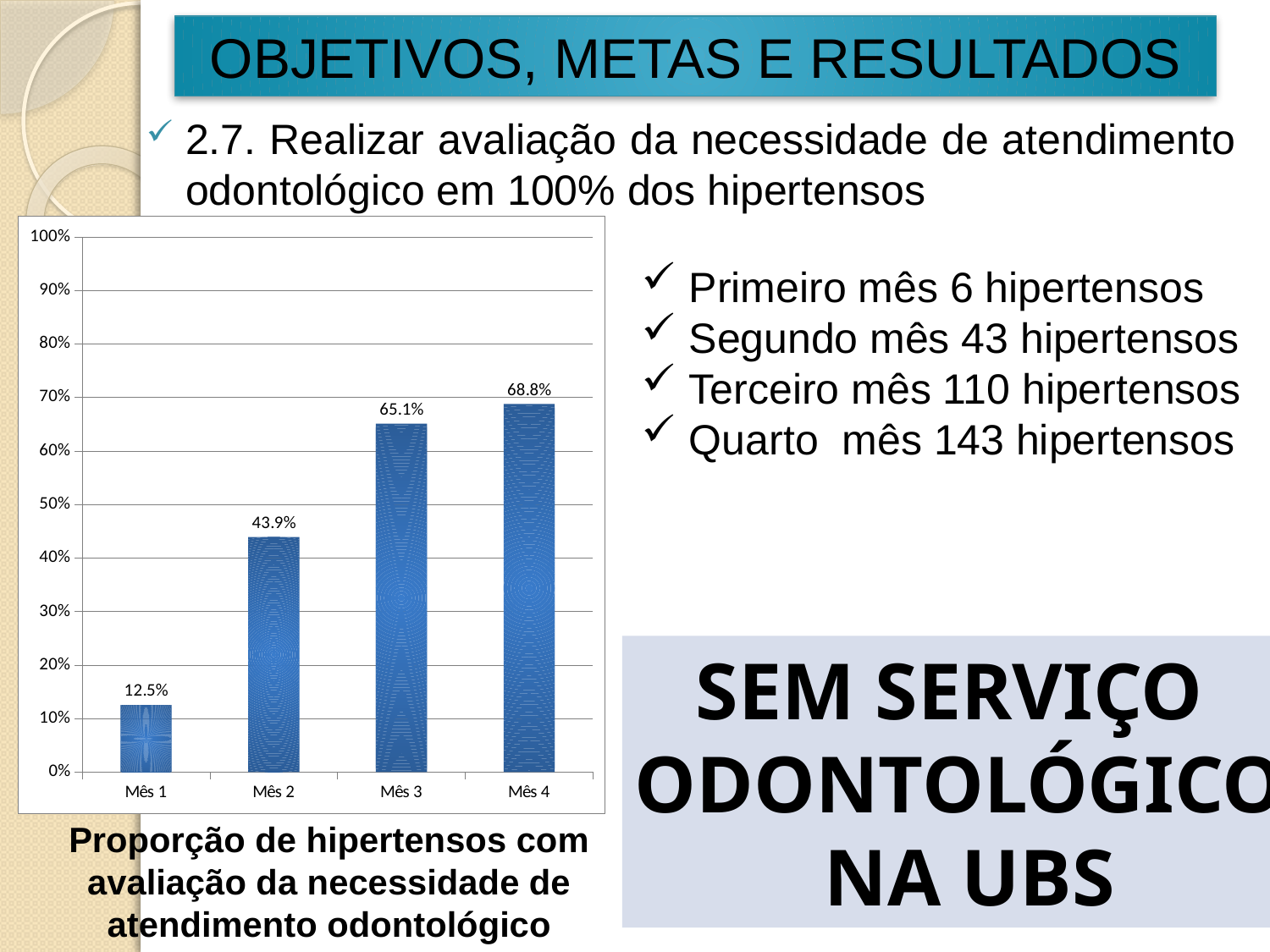
What is the value for Mês 4? 68.8% What is the difference between the values for Mês 3 and Mês 2? 21.2% Do the values rise or fall from Mês 1 to Mês 4? Rise What kind of chart is shown? Bar chart How many categories are shown on the x axis? 4 What is the difference between the values for Mês 4 and Mês 1? 56.3% What is the value for Mês 3? 65.1% Which month has the lowest value? Mês 1 Which month has the highest value? Mês 4 What is the value for Mês 2? 43.9% What is the value for Mês 1? 12.5% Which is larger, the value for Mês 2 or the value for Mês 3? Mês 3